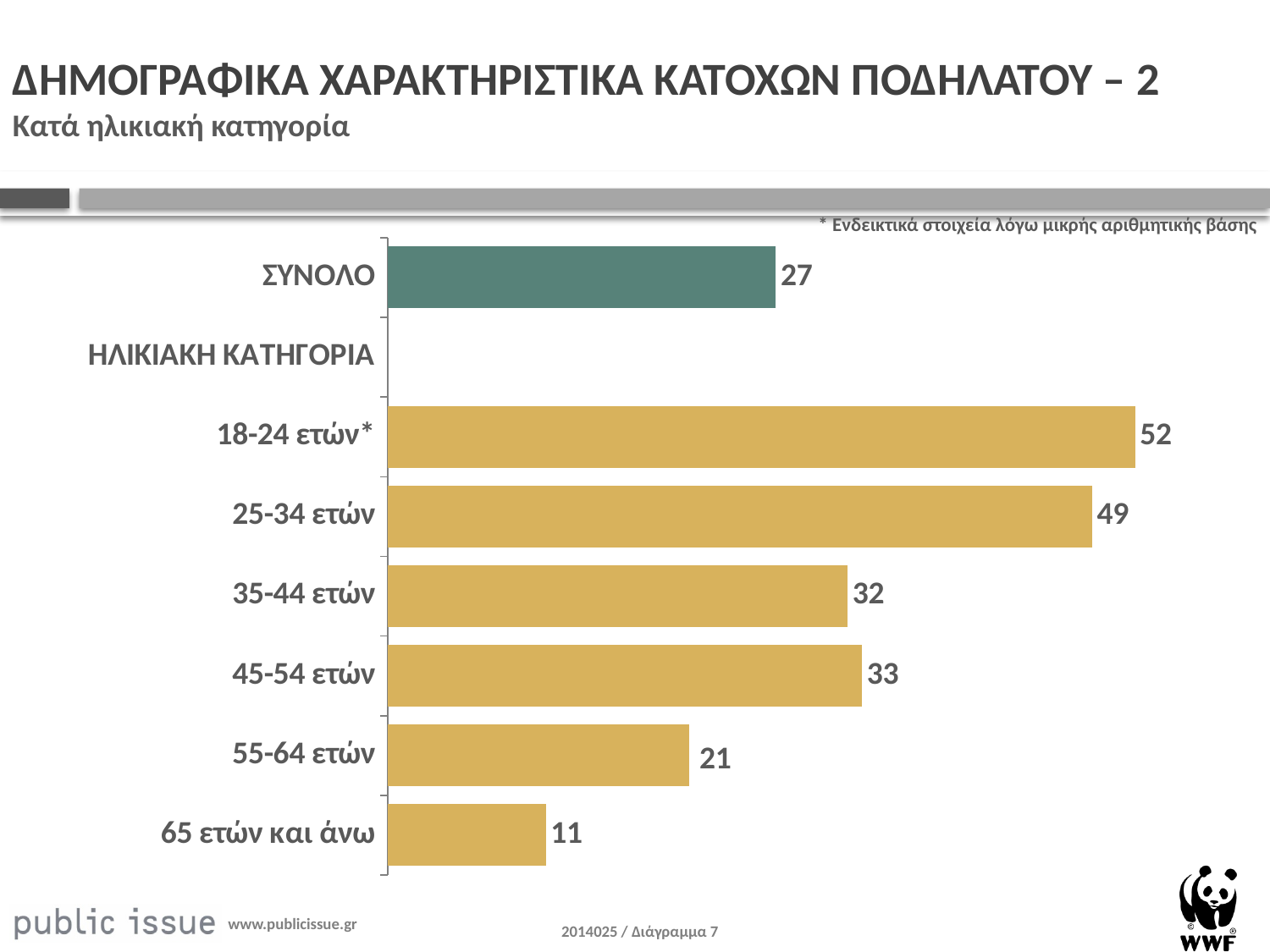
How many age categories (excluding ΣΥΝΟΛΟ) have bars plotted? 6 What is the difference between the values for 18-24 ετών* and 25-34 ετών? 3 What is the value for 18-24 ετών*? 52 Which is larger, the value for 35-44 ετών or the value for 55-64 ετών? 35-44 ετών What is the value for 65 ετών και άνω? 11 What is the value for 45-54 ετών? 33 What is the difference between the values for 55-64 ετών and 65 ετών και άνω? 10 Which age category has the highest value? 18-24 ετών* What colour is the bar for ΣΥΝΟΛΟ? Teal/green What is the value for ΣΥΝΟΛΟ? 27 What kind of chart is shown on the slide? Bar chart Which age category has the lowest value? 65 ετών και άνω